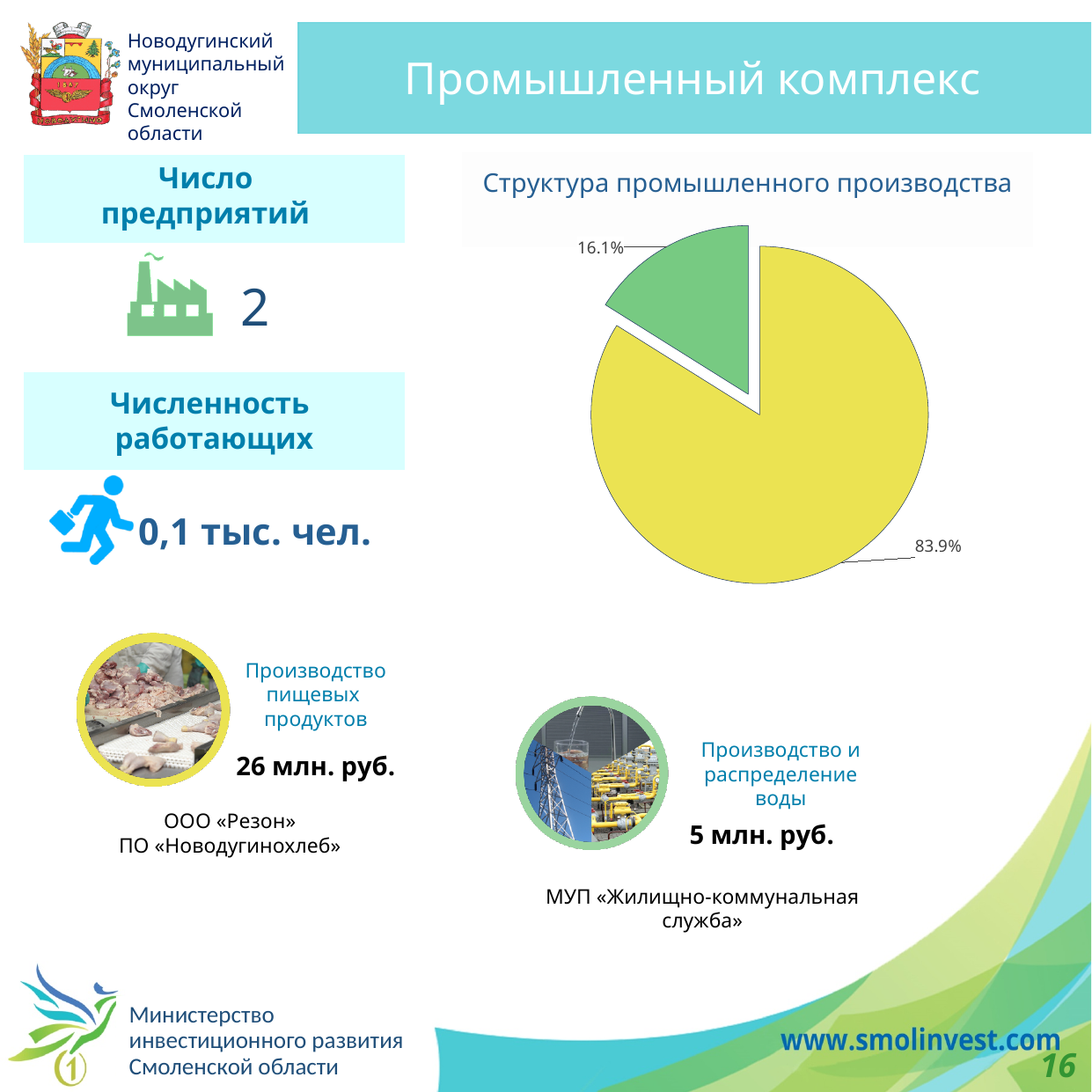
What is the title of the pie chart on the slide? Структура промышленного производства What share of the pie does the slice labelled 83.9% represent? 83.9% What kind of chart is shown under the title "Структура промышленного производства"? pie chart Is the green slice of the pie chart larger or smaller than the yellow slice? smaller What percentage is shown for the yellow slice of the pie chart? 83.9% How many slices does the pie chart have? 2 What is the difference in percentage points between the yellow slice and the green slice of the pie chart? 67.8 Which slice of the pie chart is the largest, the green one or the yellow one? the yellow one Which slice of the pie chart is the smallest, the green one or the yellow one? the green one What colour is the slice that is pulled out from the pie chart? green What percentage is shown for the green slice of the pie chart? 16.1%